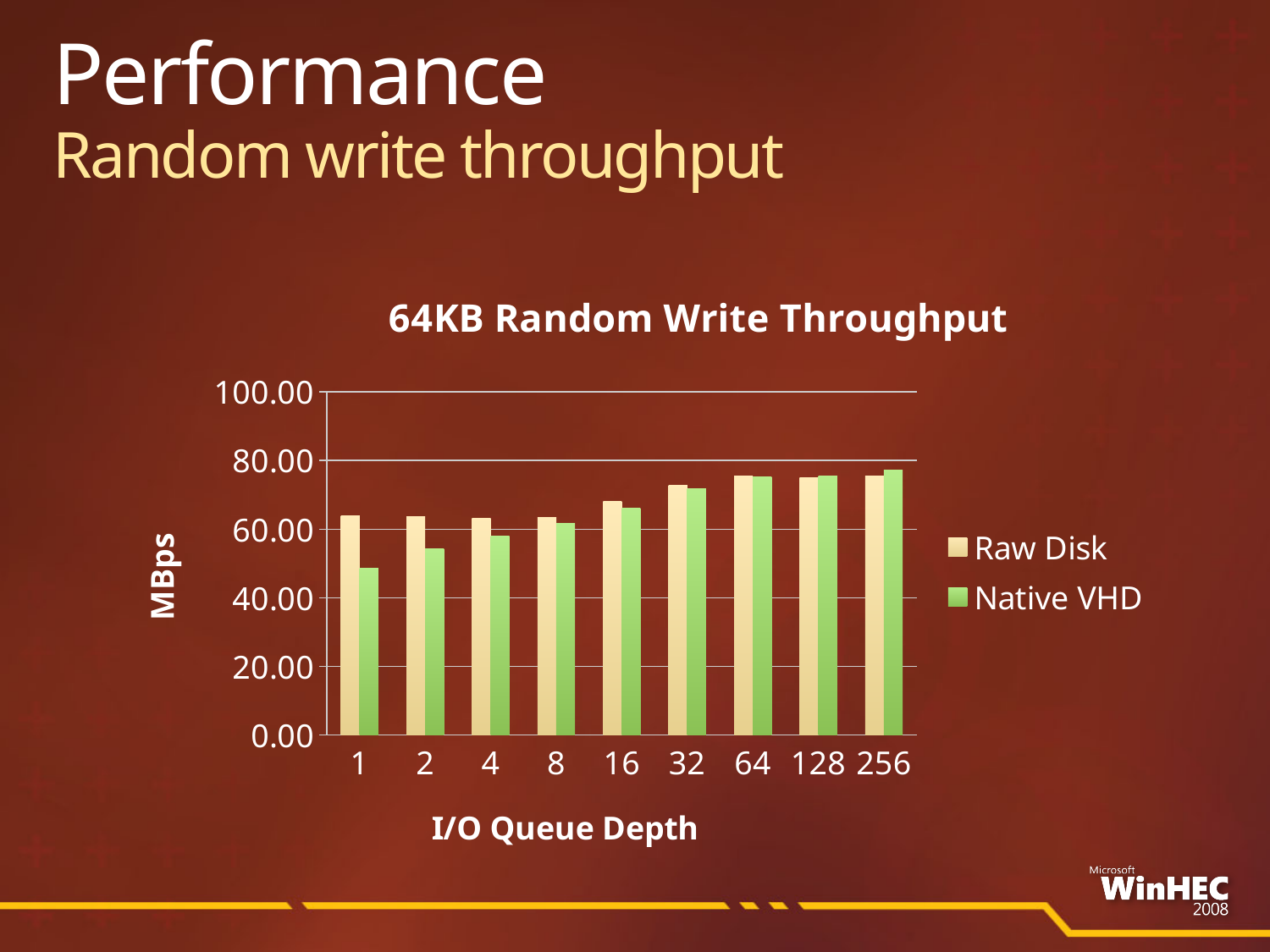
At I/O queue depth 1, which series has the larger value, Raw Disk or Native VHD? Raw Disk What is the label on the vertical axis of the chart? MBps How many series does the legend list? 2 Is the Native VHD value at I/O queue depth 2 greater or less than 60.00? less Is the Native VHD value at I/O queue depth 1 greater or less than 60.00? less How many I/O queue depth categories are shown on the x axis? 9 What kind of chart is shown on the slide? bar chart Is the Raw Disk value at I/O queue depth 64 greater or less than 60.00? greater At which I/O queue depth is the Native VHD value lowest? 1 Do the Native VHD values rise or fall as I/O queue depth increases along the x axis? rise